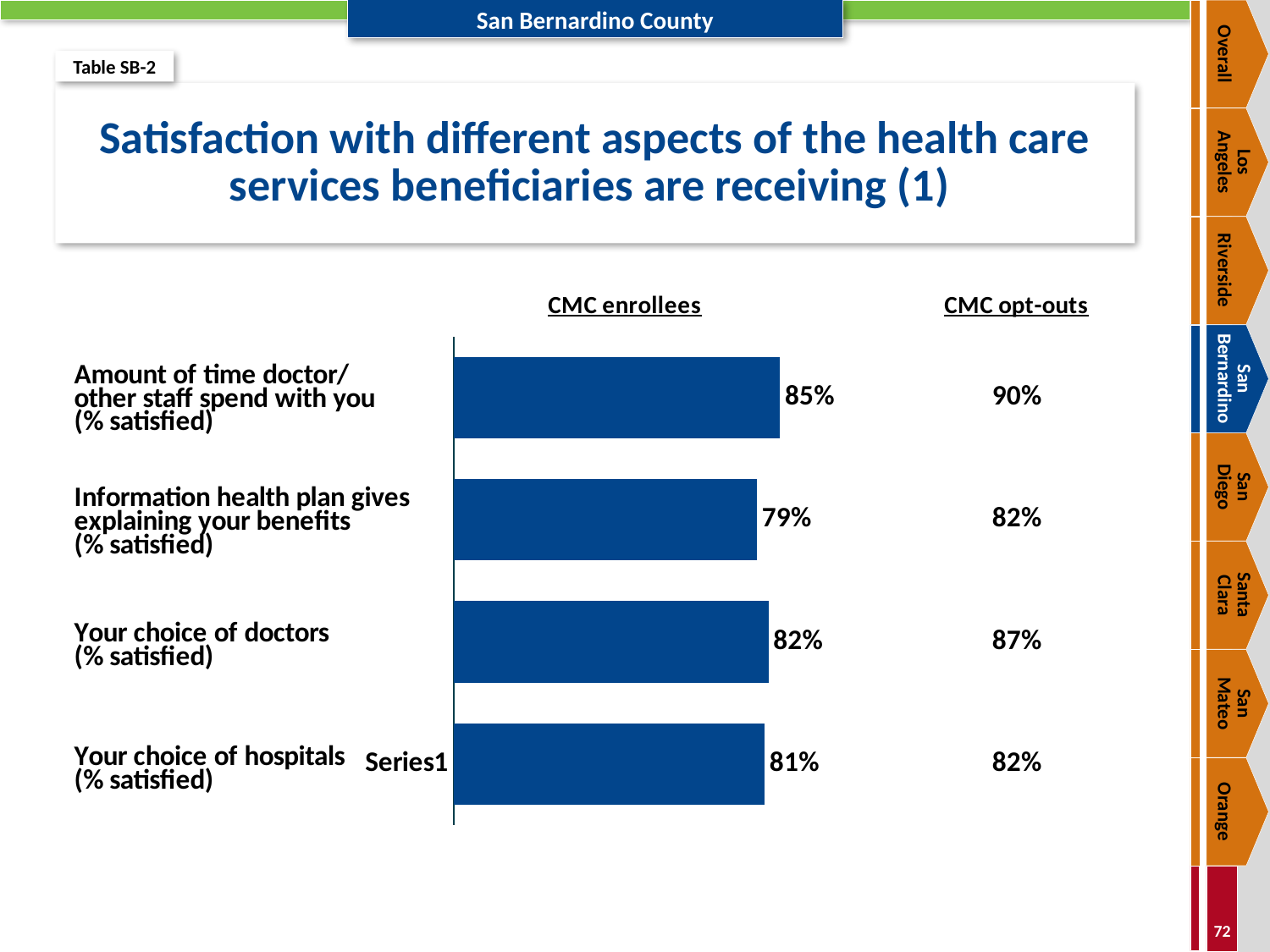
What percentage of CMC enrollees are satisfied with the amount of time the doctor/other staff spend with them? 85% What is the CMC opt-outs satisfaction value printed next to the bar for 'Your choice of doctors'? 87% For CMC enrollees, which is higher: satisfaction with choice of doctors or satisfaction with choice of hospitals? Your choice of doctors What is the difference between CMC enrollees' satisfaction with the amount of time doctor/other staff spend with them and with the information the health plan gives explaining benefits? 6 percentage points Which aspect has the highest satisfaction among CMC enrollees? Amount of time doctor/other staff spend with you What is the CMC enrollees' satisfaction value for 'Your choice of hospitals'? 81% What percentage of CMC enrollees are satisfied with the information the health plan gives explaining their benefits? 79% How many aspects of health care services are shown as bars in the chart? 4 What is the CMC enrollees' satisfaction value for 'Your choice of doctors'? 82% What type of chart is used to show the CMC enrollees' satisfaction values? Bar chart Which aspect has the lowest satisfaction among CMC enrollees? Information health plan gives explaining your benefits What series name is shown next to the bottom bar of the chart? Series1